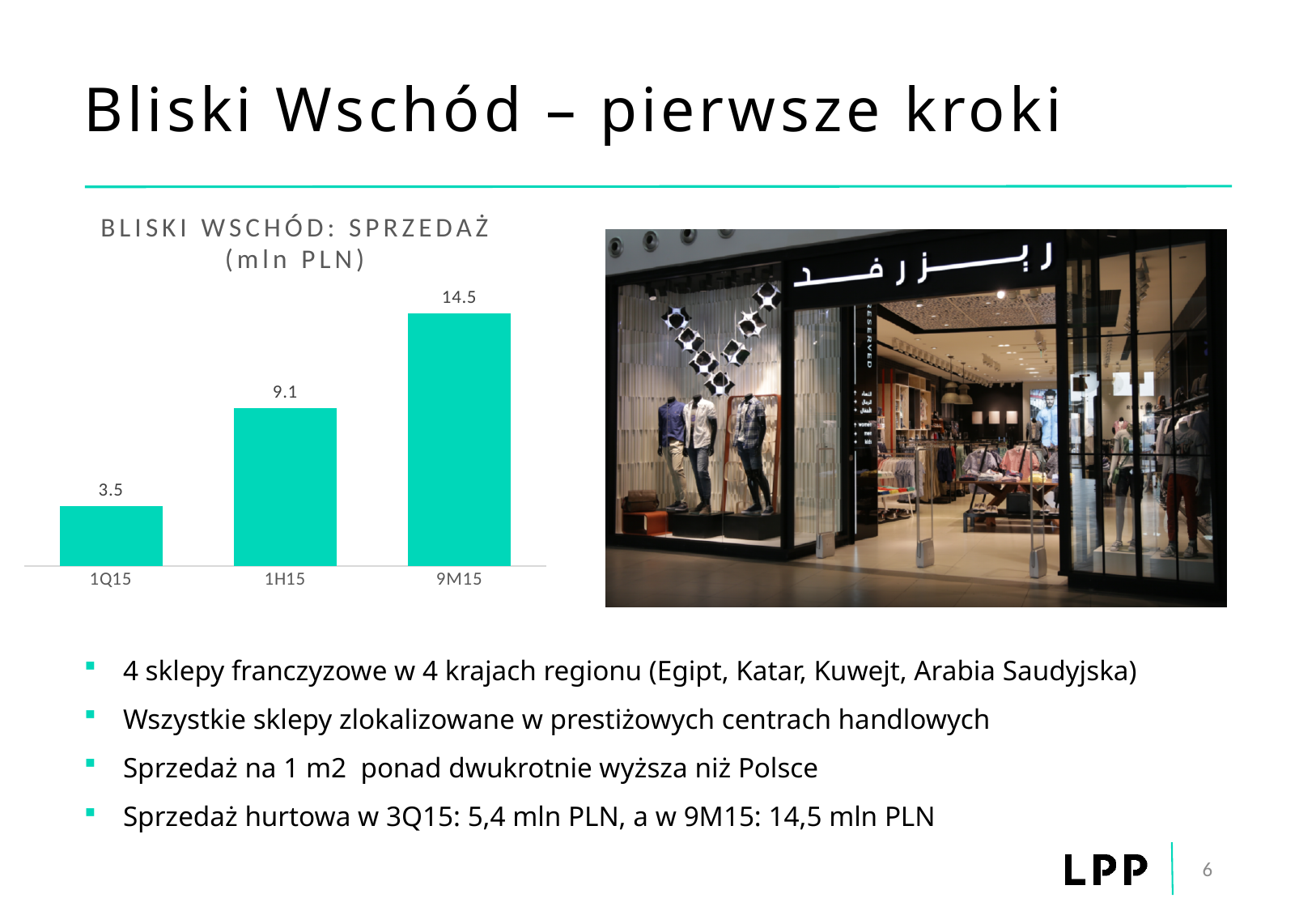
What is the title of the chart? BLISKI WSCHÓD: SPRZEDAŻ (mln PLN) Which is larger, the value for 1H15 or the value for 1Q15? 1H15 Which category has the lowest value in the chart? 1Q15 What is the value for 1Q15 in the chart? 3.5 What is the value for 1H15 in the chart? 9.1 What is the value for 9M15 in the chart? 14.5 Which category has the highest value in the chart? 9M15 How many categories are shown in the chart? 3 Do the values rise or fall from 1Q15 to 9M15? rise What is the difference between the values for 9M15 and 1H15? 5.4 What is the difference between the values for 1H15 and 1Q15? 5.6 What kind of chart is shown on the slide? bar chart